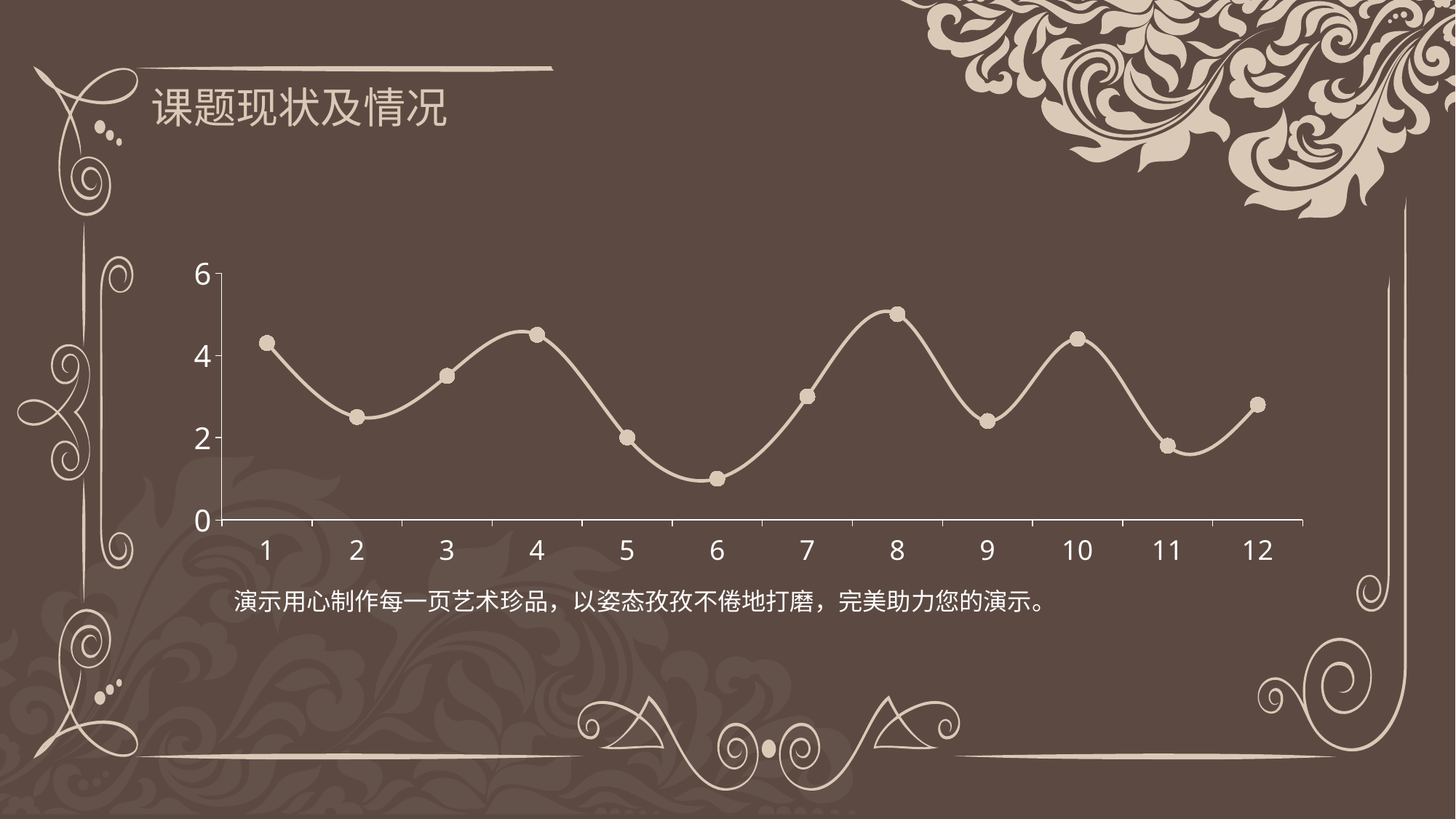
Is the value at x = 1 greater or less than 4? greater How many data points are plotted on the line chart? 12 Which x-axis category has the highest value on the line chart? 8 Is the value at x = 8 greater or less than 4? greater Which x-axis category has the lowest value on the line chart? 6 Which has the larger value, x = 4 or x = 2? 4 What kind of chart is shown on the slide? line chart Does the line rise or fall from x = 4 to x = 6? fall What is the title of the slide containing the chart? 课题现状及情况 Is the value at x = 6 greater or less than 2? less